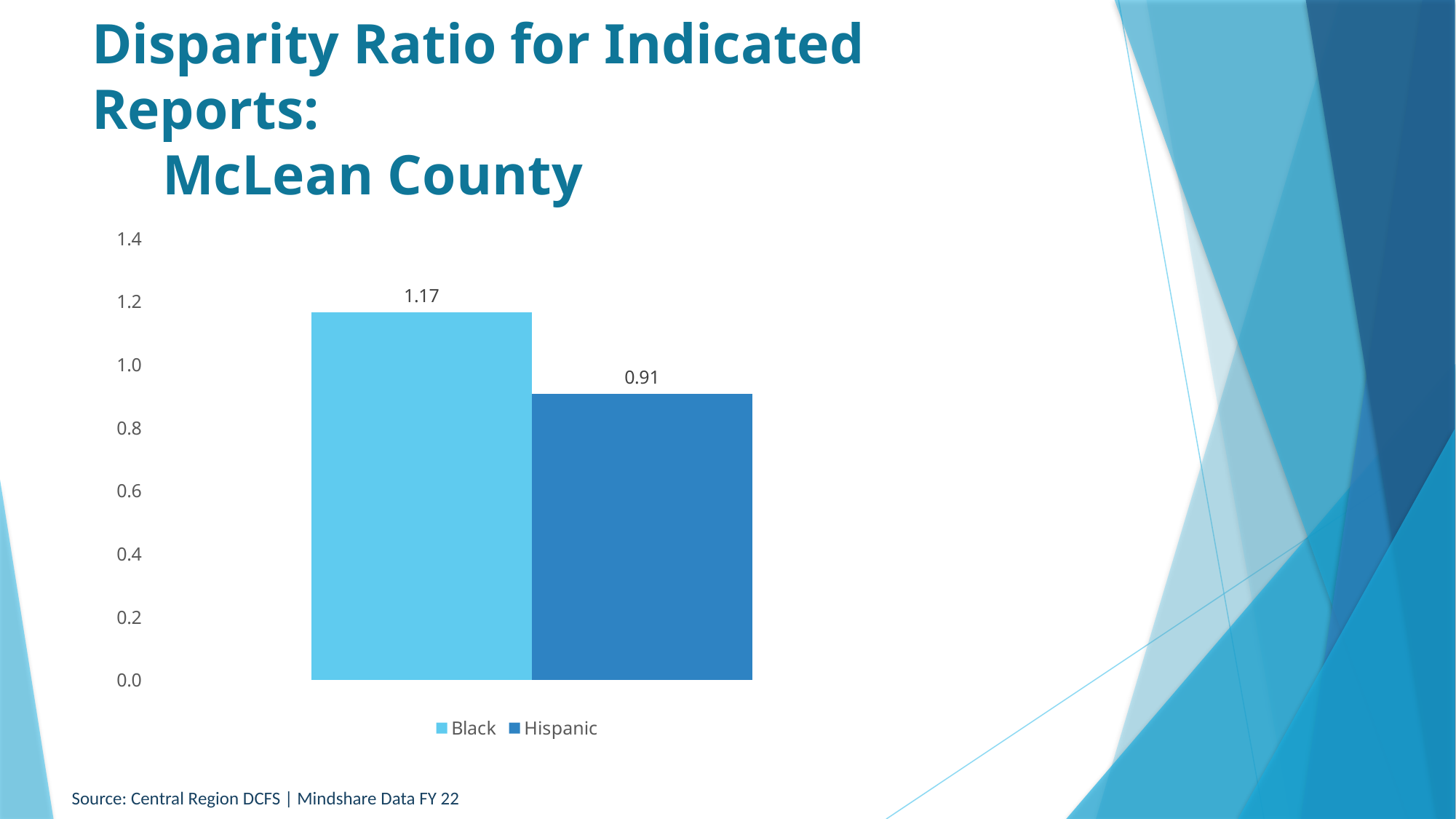
What kind of chart is shown on the slide? bar chart Is the value for Hispanic greater or less than 1.0? less Is the disparity ratio for Black larger or smaller than the ratio for Hispanic? larger What is the disparity ratio for Black? 1.17 How many bars are plotted in the chart? 2 Which series has the lower disparity ratio? Hispanic Is the value for Black greater or less than 1.0? greater What is the difference between the Black and Hispanic disparity ratios? 0.26 What is the disparity ratio for Hispanic? 0.91 Which series has the higher disparity ratio? Black How many series does the legend list? 2 What is the maximum value shown on the vertical axis? 1.4